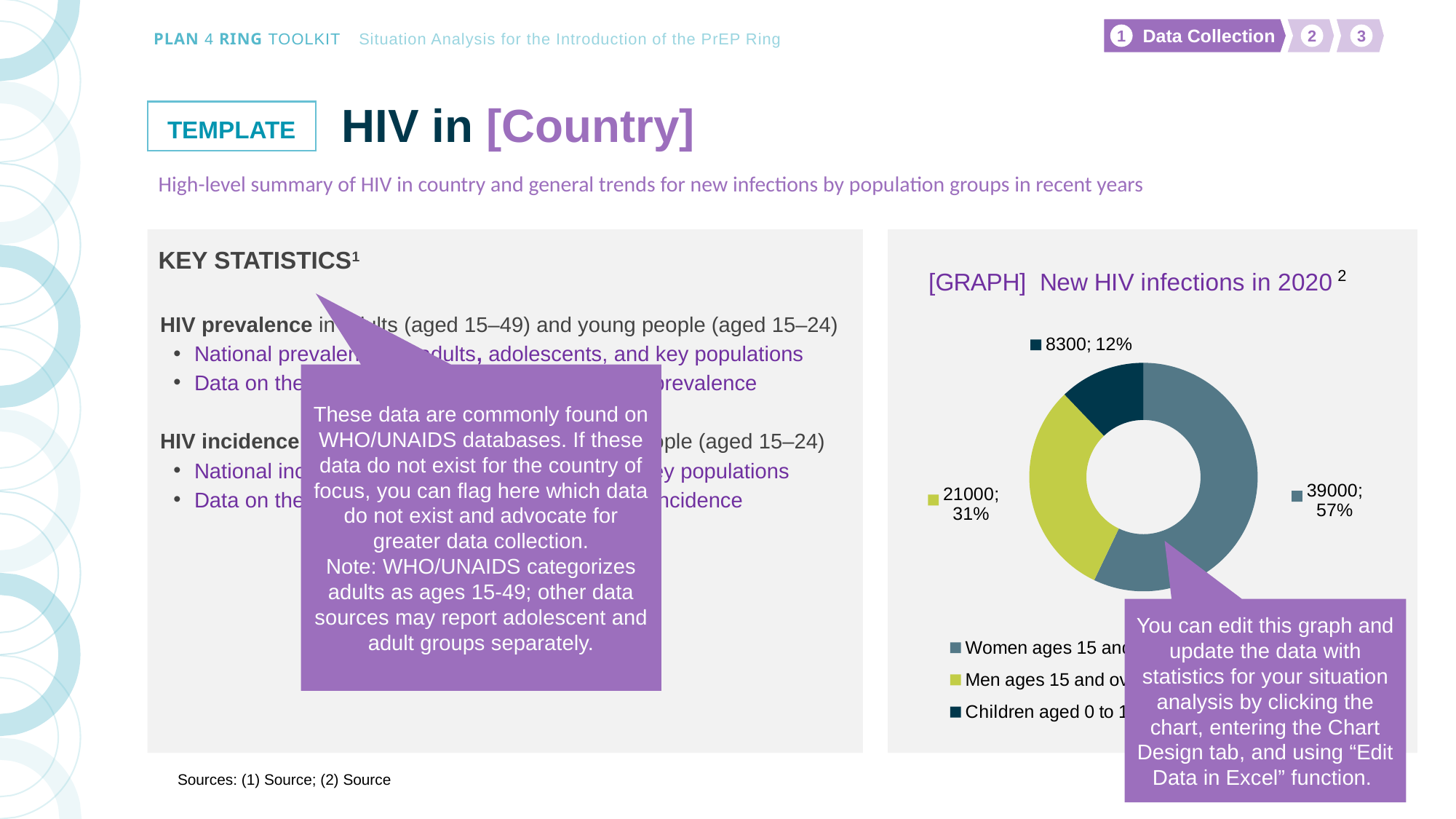
Which slice of the chart is the smallest? Children What is the value shown for the men slice in the chart? 21000 Which slice of the chart is the largest? Women What kind of chart is shown on the slide? Doughnut chart What share of new HIV infections in 2020 does the women slice represent? 57% What is the title of the chart on the slide? [GRAPH] New HIV infections in 2020 What is the value shown for the children slice in the chart? 8300 What is the difference between the women value and the men value in the chart? 18000 Which is larger in the chart, the men slice or the children slice? Men What is the value shown for the women slice in the chart? 39000 What share of new HIV infections in 2020 does the children slice represent? 12% How many slices does the doughnut chart have? 3